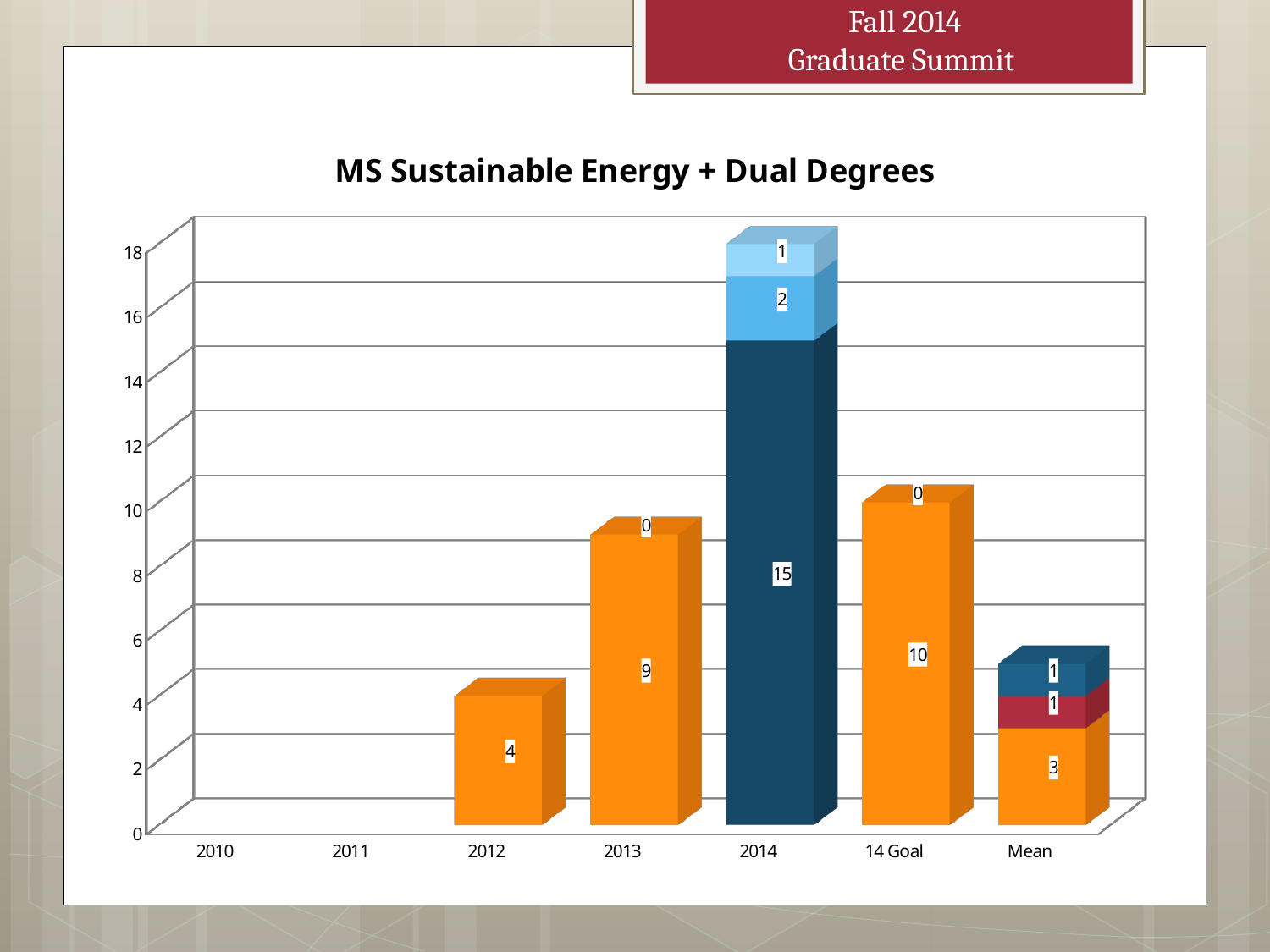
What is the total of the stacked bar for 2014? 18 What is the difference between the orange segment of 14 Goal and the orange segment of 2013? 1 What is the value of the largest (dark blue) segment of the 2014 bar? 15 What is the value labelled on the bar for 2012? 4 What kind of chart is shown on the slide? bar chart What is the value of the bottom (orange) segment of the Mean bar? 3 How many categories are shown on the x axis? 7 What is the title of the chart? MS Sustainable Energy + Dual Degrees Which bar is taller, 2013 or 14 Goal? 14 Goal Which category has the tallest bar? 2014 Is the total height of the 2014 bar greater or less than 16? greater What is the total of the stacked bar for Mean? 5